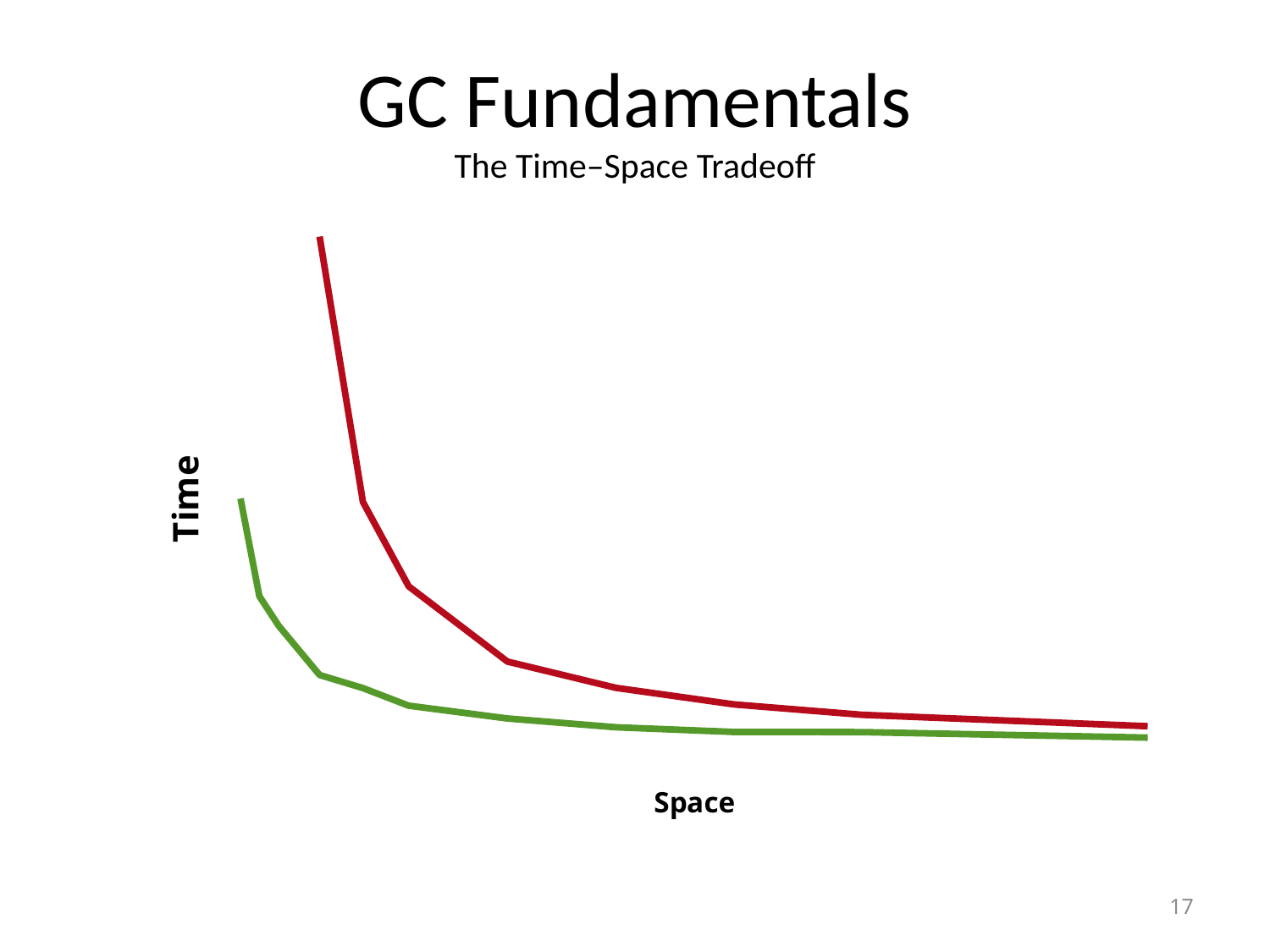
Does the red line rise or fall as it moves from left to right? fall What kind of chart is shown on the slide? line chart Does the green line rise or fall as it moves from left to right? fall What is the label of the vertical axis? Time Which line starts at a higher Time value at its left end, the red line or the green line? the red line What is the label of the horizontal axis? Space Which line shows the higher Time values, the red line or the green line? the red line As Space increases along the x axis, does Time rise or fall? fall How many lines are plotted on the chart? 2